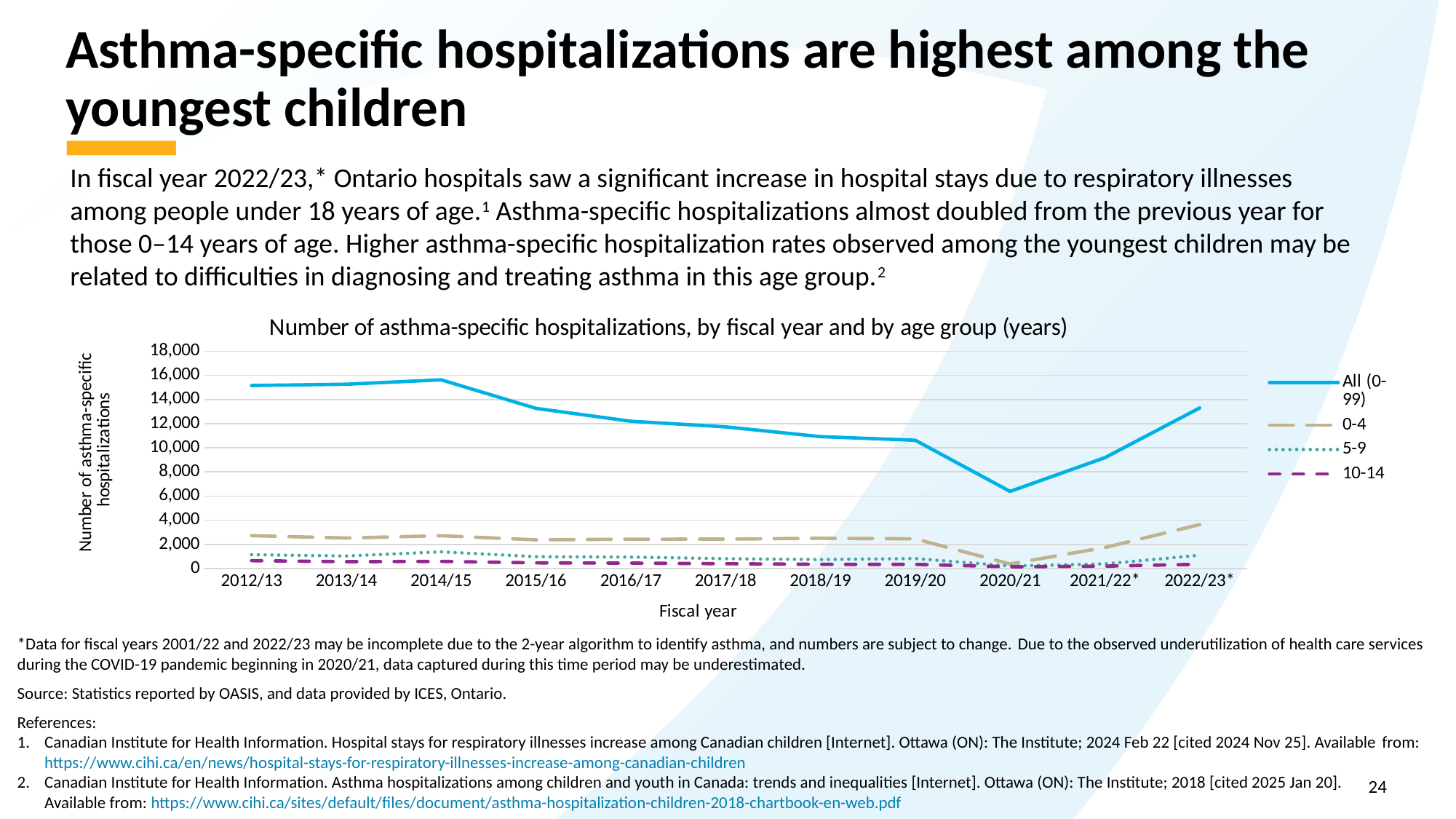
How many series does the legend list? 4 Which age group series has the lowest values across the chart? 10-14 Is the value for All (0-99) in 2014/15 greater or less than 14,000? greater Which fiscal year has the lowest value for the All (0-99) series? 2020/21 In 2012/13, which age group has the larger value: 0-4 or 10-14? 0-4 How many fiscal years are plotted along the x axis? 11 What kind of chart is shown on the slide? line chart Is the value for All (0-99) in 2020/21 greater or less than 8,000? less Is the value for the 0-4 age group in 2022/23* greater or less than 2,000? greater Which fiscal year has the highest value for the All (0-99) series? 2014/15 Does the All (0-99) series rise or fall between 2014/15 and 2020/21? fall What is the title of the chart? Number of asthma-specific hospitalizations, by fiscal year and by age group (years)